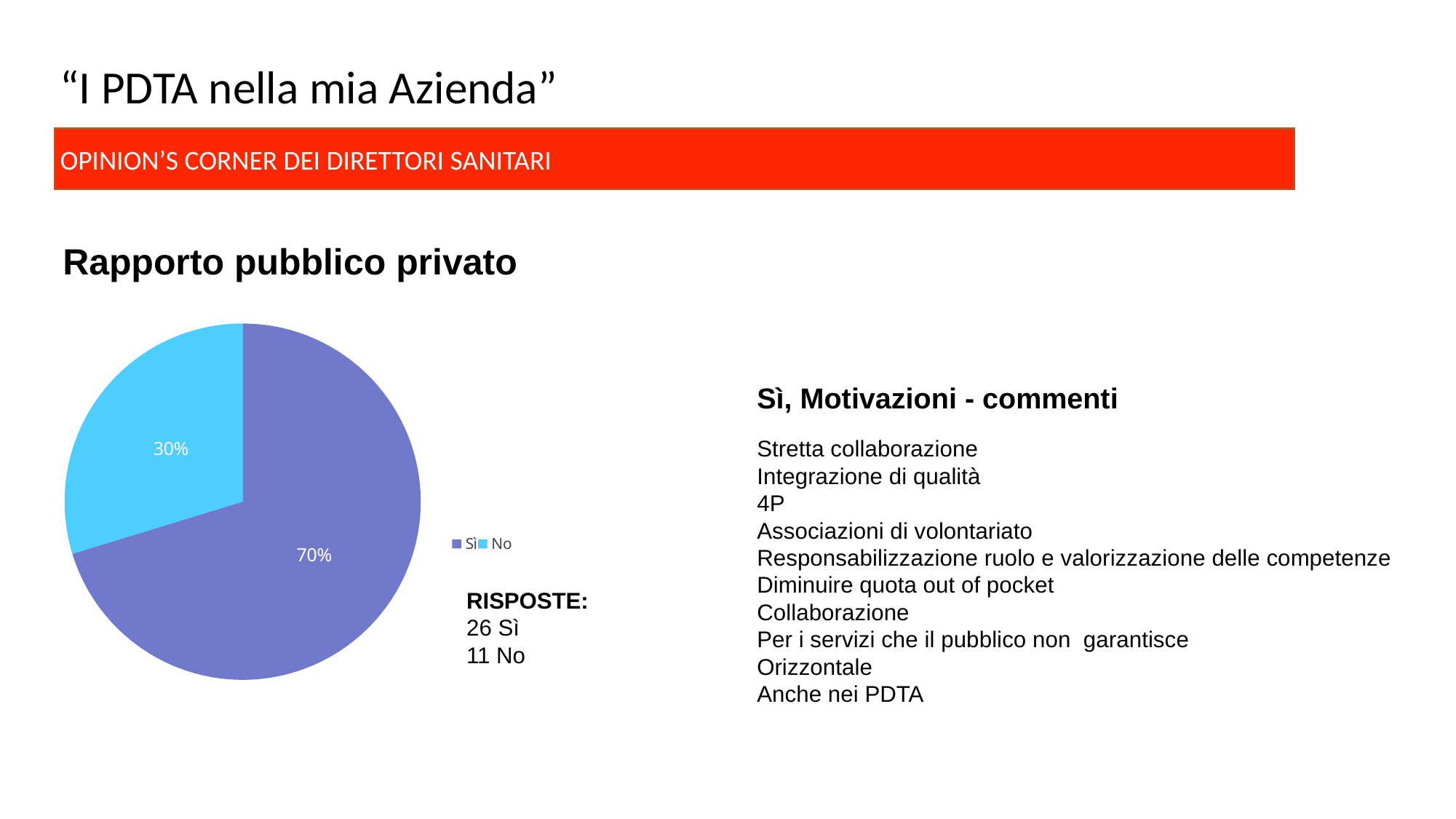
How many entries does the legend of the pie chart list? 2 Which is larger in the pie chart, "Sì" or "No"? Sì Which slice of the pie chart is the largest? Sì What kind of chart is shown on the slide? pie chart What is the heading above the pie chart? Rapporto pubblico privato Which slice of the pie chart is the smallest? No What colour is the "Sì" slice in the pie chart? purple What percentage of the pie chart is the "Sì" slice? 70% What percentage of the pie chart is the "No" slice? 30% What share of the pie does the "No" slice represent? 30% How many slices does the pie chart have? 2 What is the difference in percentage points between the "Sì" and "No" slices? 40